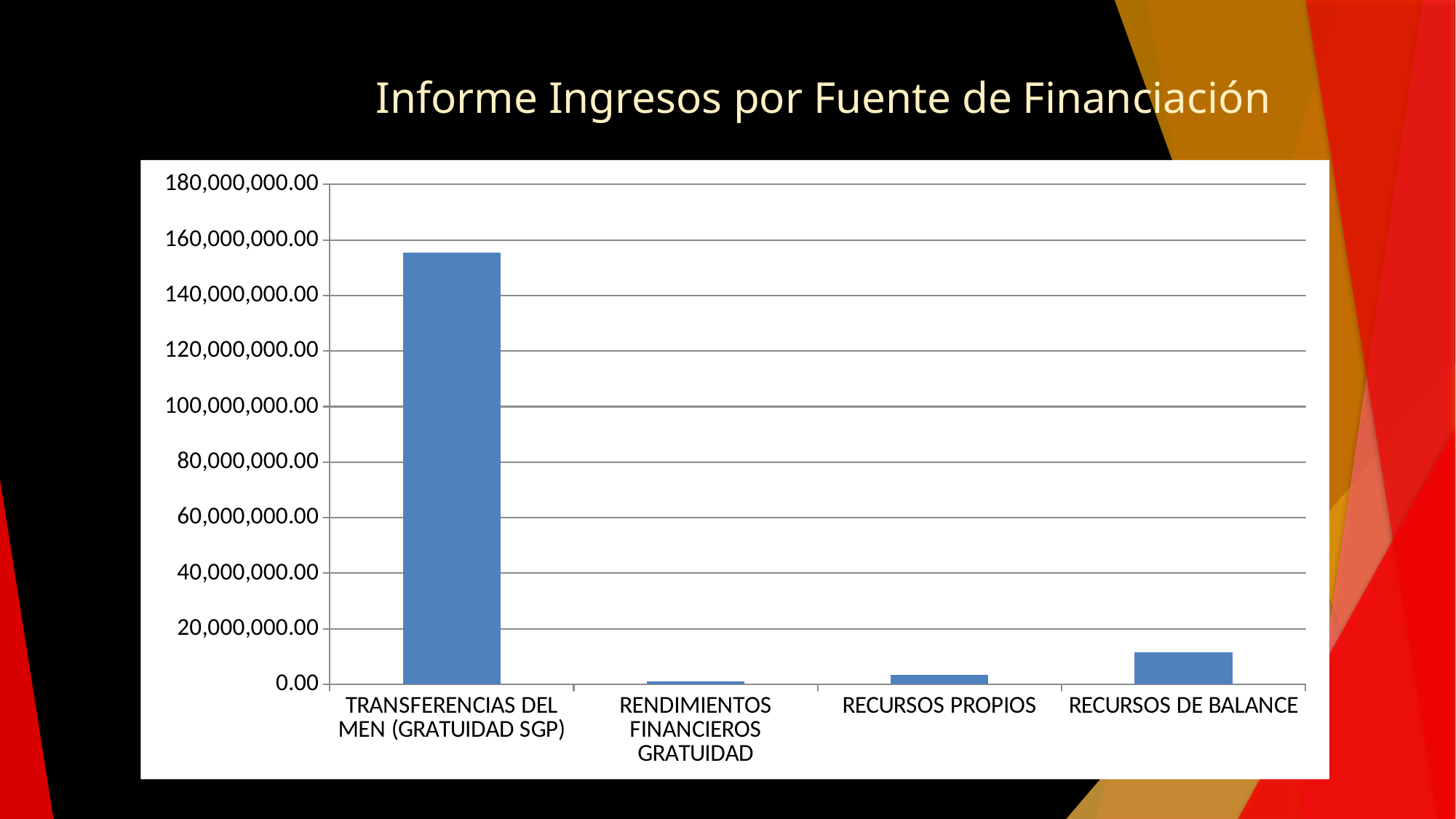
Is the value for TRANSFERENCIAS DEL MEN (GRATUIDAD SGP) greater or less than 160,000,000.00? less Is the value for TRANSFERENCIAS DEL MEN (GRATUIDAD SGP) greater or less than 140,000,000.00? greater Which is larger, the value for RECURSOS DE BALANCE or the value for RECURSOS PROPIOS? RECURSOS DE BALANCE What is the title shown above the chart on the slide? Informe Ingresos por Fuente de Financiación Is the value for RECURSOS PROPIOS greater or less than 20,000,000.00? less Which is larger, the value for TRANSFERENCIAS DEL MEN (GRATUIDAD SGP) or the value for RECURSOS DE BALANCE? TRANSFERENCIAS DEL MEN (GRATUIDAD SGP) What is the highest value shown on the y axis of the chart? 180,000,000.00 How many categories are shown on the x axis of the chart? 4 Which category has the lowest value in the chart? RENDIMIENTOS FINANCIEROS GRATUIDAD Which category has the highest value in the chart? TRANSFERENCIAS DEL MEN (GRATUIDAD SGP) What type of chart is shown on the slide? Bar chart